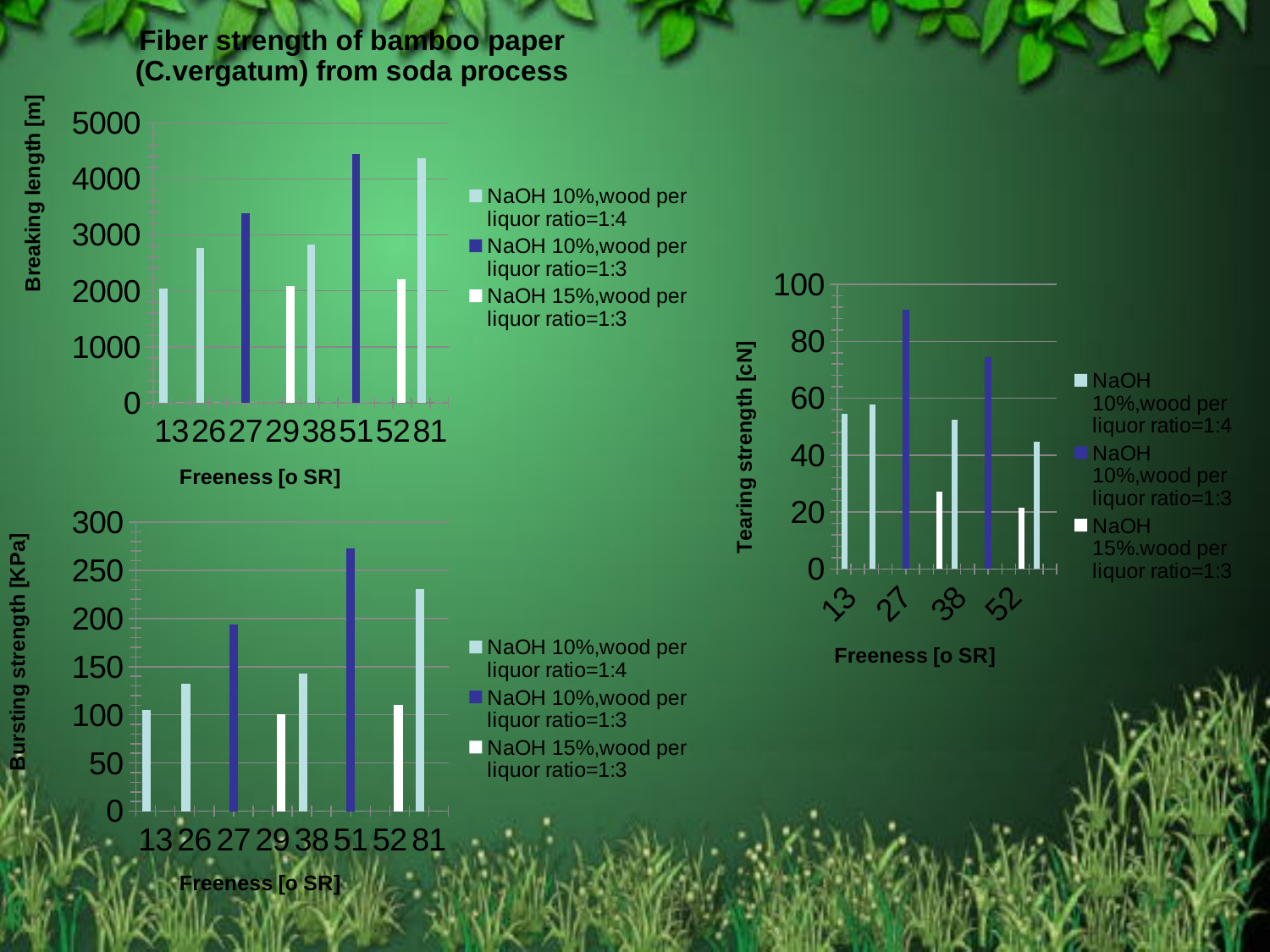
In the Breaking length chart, which is larger, the value for freeness 27 or the value for freeness 29? 27 What is the y-axis title of the Tearing strength chart? Tearing strength [cN] In the Breaking length chart, is the value for freeness 13 greater or less than 3000? less In the Bursting strength chart, is the value for freeness 51 greater or less than 250? greater How many series does the legend of the Breaking length chart list? 3 In the Tearing strength chart, is the tallest bar greater or less than 80? greater How many freeness categories are labelled on the x axis of the Breaking length chart? 8 What kind of chart is the Breaking length chart on the slide? bar chart In the Bursting strength chart, which freeness category has the highest value? 51 In the Bursting strength chart, which is larger, the value for freeness 81 or the value for freeness 38? 81